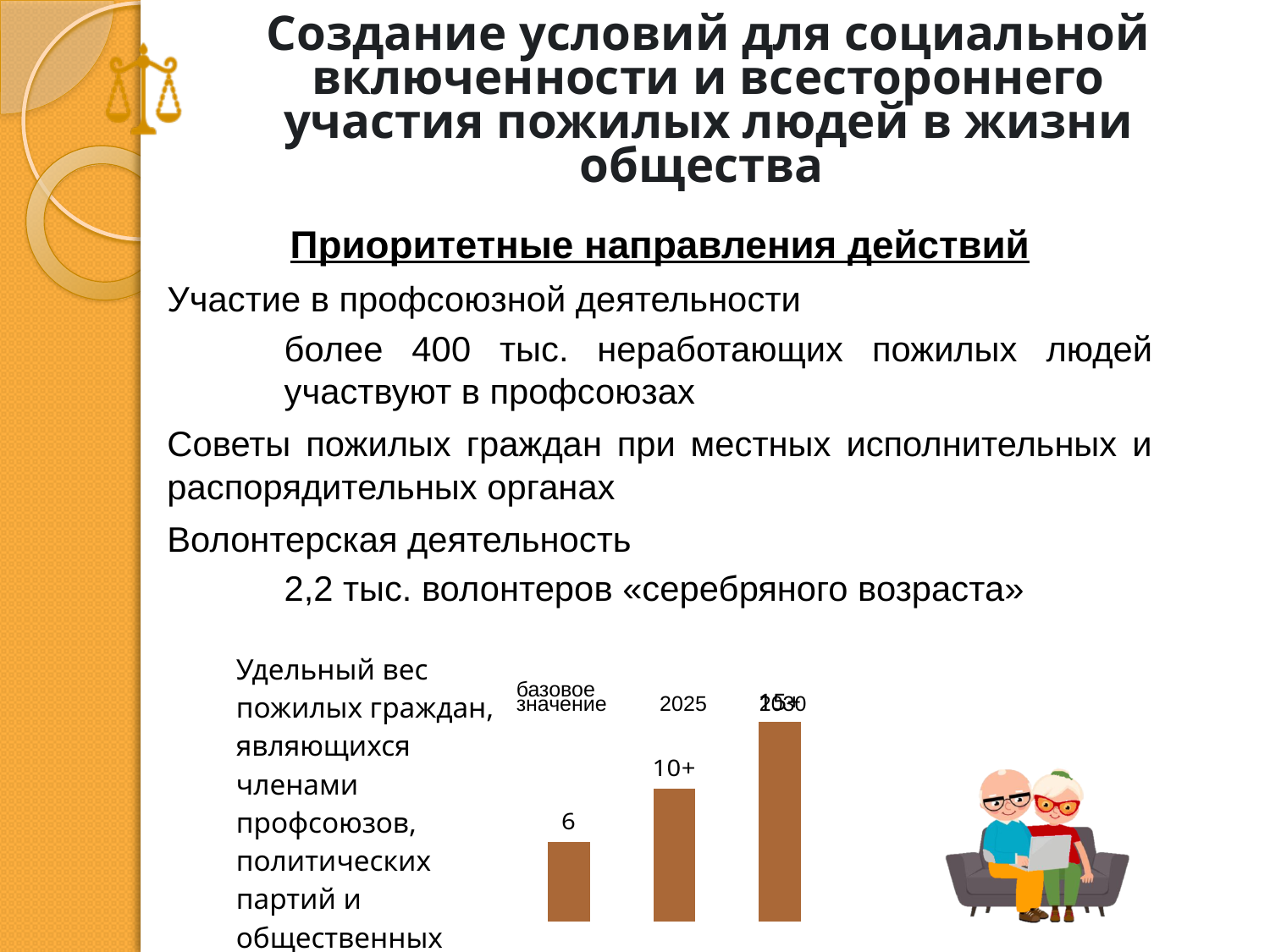
Do the bar values rise or fall from 'базовое значение' to 2030? rise What is the label of the first category in the chart? базовое значение What colour are the bars in the chart? brown What kind of chart is shown on the slide? bar chart Which category has the shortest bar in the chart? базовое значение Which category has the tallest bar in the chart? 2030 Which bar is taller: 'базовое значение' or 2025? 2025 What is the value shown for the 'базовое значение' bar in the chart? 6 What is the value shown for the 2025 bar in the chart? 10+ Which bar is taller: 2025 or 2030? 2030 How many bars are plotted in the chart? 3